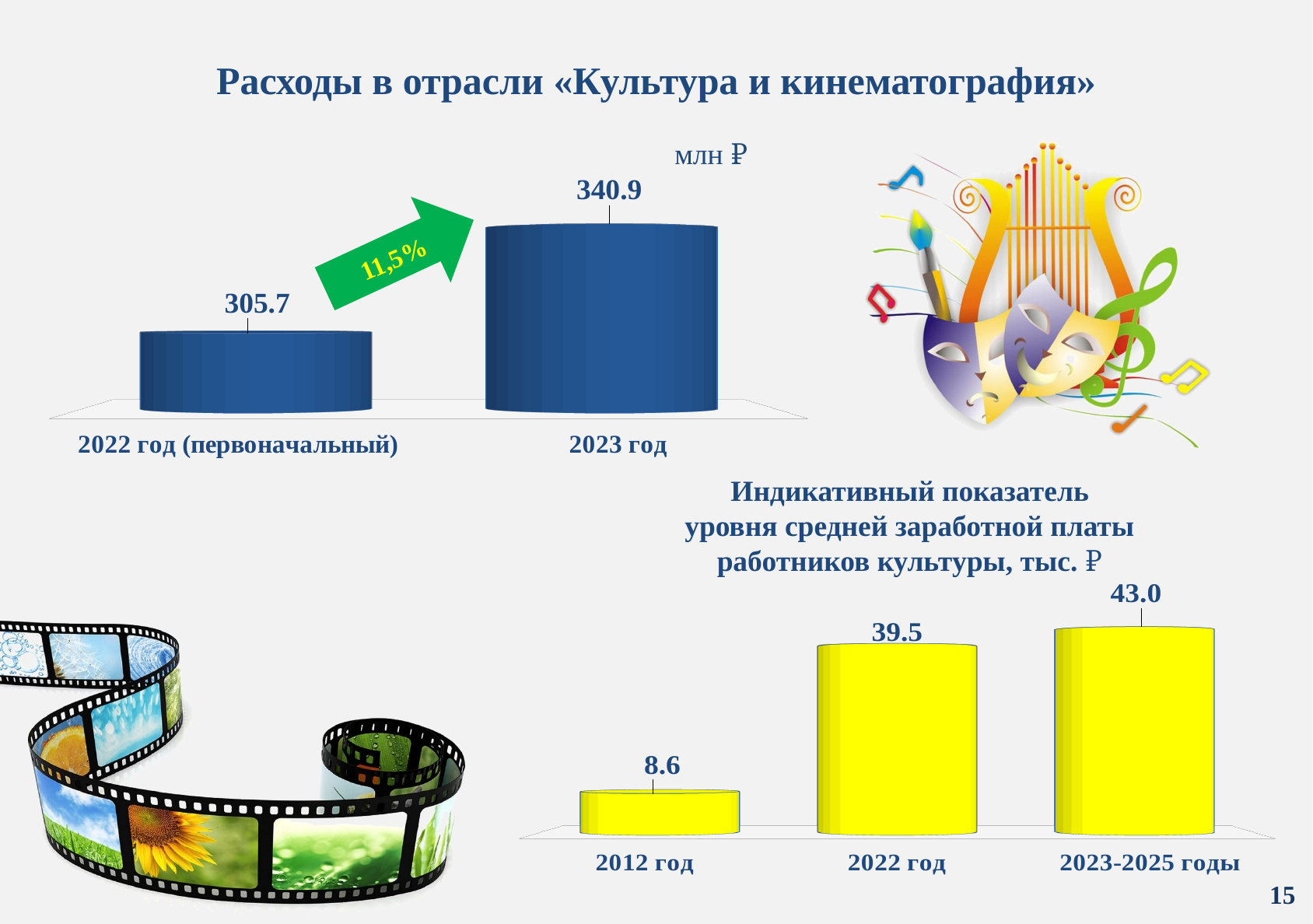
In the top chart of expenditures in the 'Культура и кинематография' sector, by how much does the 2023 год value exceed the 2022 год (первоначальный) value? 35.2 In the top chart of expenditures in the 'Культура и кинематография' sector, what is the value for 2023 год? 340.9 In the top chart of expenditures in the 'Культура и кинематография' sector, what is the value for 2022 год (первоначальный)? 305.7 In the bottom-right chart of the indicative average salary of culture workers, what is the value for 2023-2025 годы? 43.0 In the bottom-right chart of the indicative average salary of culture workers, which category has the highest value? 2023-2025 годы What type of chart is the bottom-right chart of the indicative average salary of culture workers? bar chart In the bottom-right chart of the indicative average salary of culture workers, what is the value for 2012 год? 8.6 In the top chart of expenditures in the 'Культура и кинематография' sector, what percentage growth is shown on the green arrow? 11,5% In the top chart of expenditures in the 'Культура и кинематография' sector, how many bars are plotted? 2 In the bottom-right chart of the indicative average salary of culture workers, do the values rise or fall from 2012 год to 2023-2025 годы? rise In the bottom-right chart of the indicative average salary of culture workers, what is the difference between the 2023-2025 годы value and the 2022 год value? 3.5 In the bottom-right chart of the indicative average salary of culture workers, which category has the lowest value? 2012 год